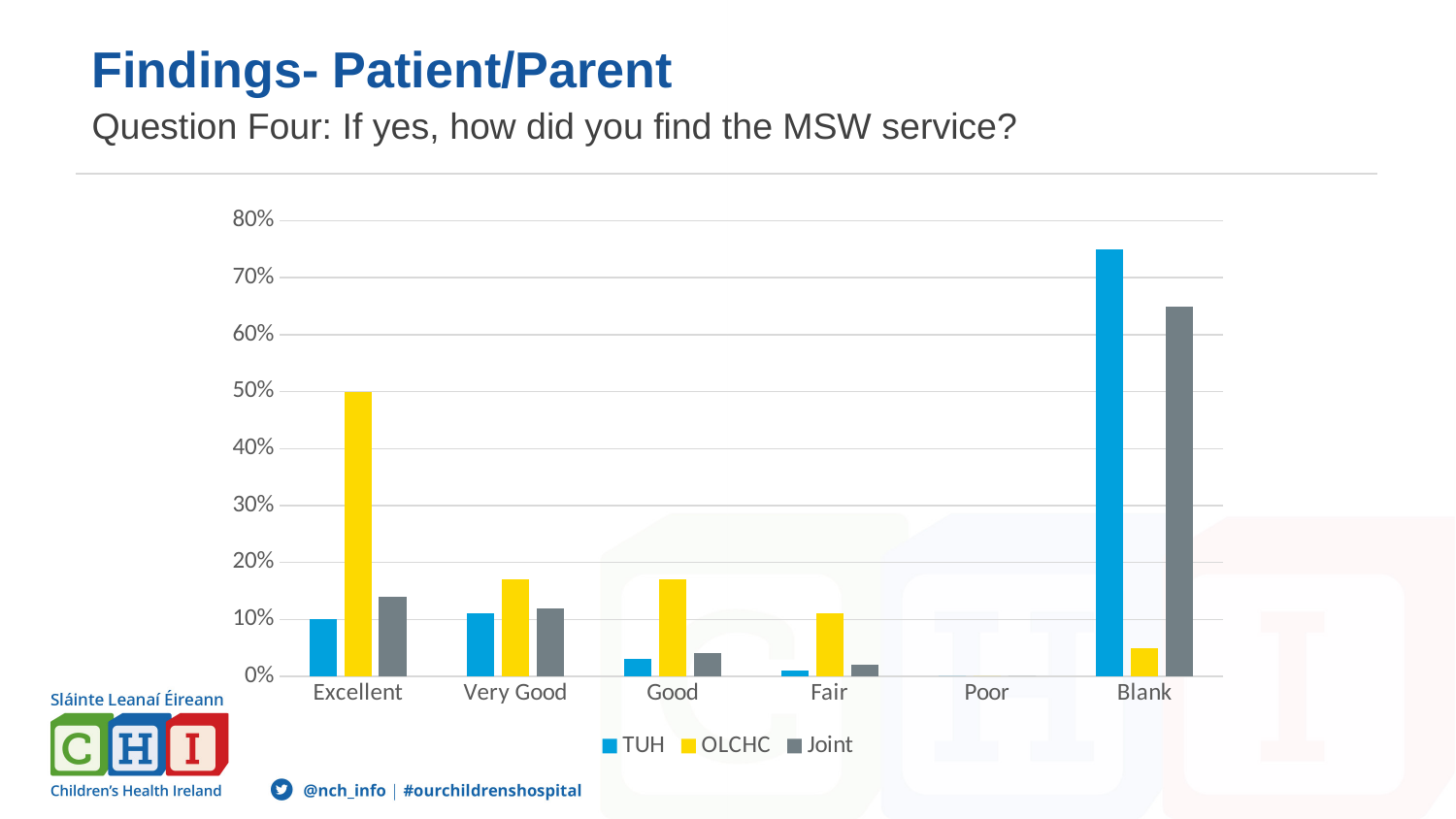
What type of chart is shown on the slide? bar chart Is the value for OLCHC in the Blank category greater or less than 10%? less Which category has the highest value for TUH? Blank Is the value for TUH in the Blank category greater or less than 70%? greater Which category has the highest value for OLCHC? Excellent In the Excellent category, which series has the larger value, OLCHC or Joint? OLCHC What is the value for TUH in the Excellent category? 10% Is the value for Joint in the Blank category greater or less than 60%? greater What is the value for OLCHC in the Excellent category? 50% How many categories are shown on the x axis? 6 Which series is shown in yellow in the legend? OLCHC How many series does the legend list? 3